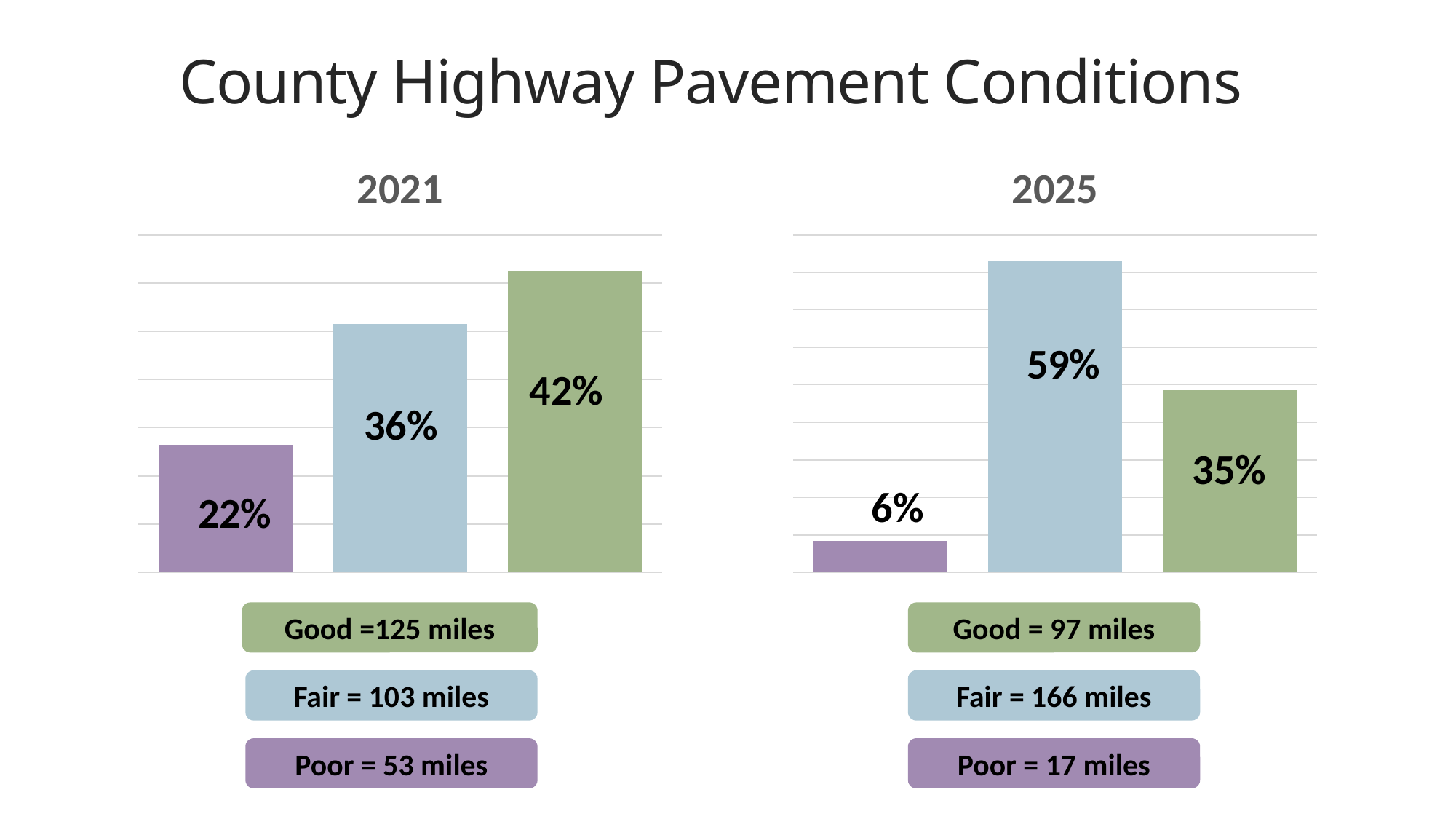
In the 2025 chart, what is the difference between the Fair and Good values? 24% In the 2021 chart, what is the difference between the Good and Poor values? 20% In the 2021 chart, what is the value for Good? 42% In the 2025 chart, which category has the lowest value? Poor In the 2021 chart, what is the value for Poor? 22% How many bars are in the 2021 chart? 3 In the 2021 chart, which category has the highest value? Good In the 2025 chart, which is larger, Fair or Good? Fair In the 2025 chart, what is the value for Fair? 59% What kind of chart is the 2025 chart? Bar chart In the 2025 chart, what is the value for Poor? 6% According to the label below the 2025 chart, how many miles of highway are in Fair condition? 166 miles